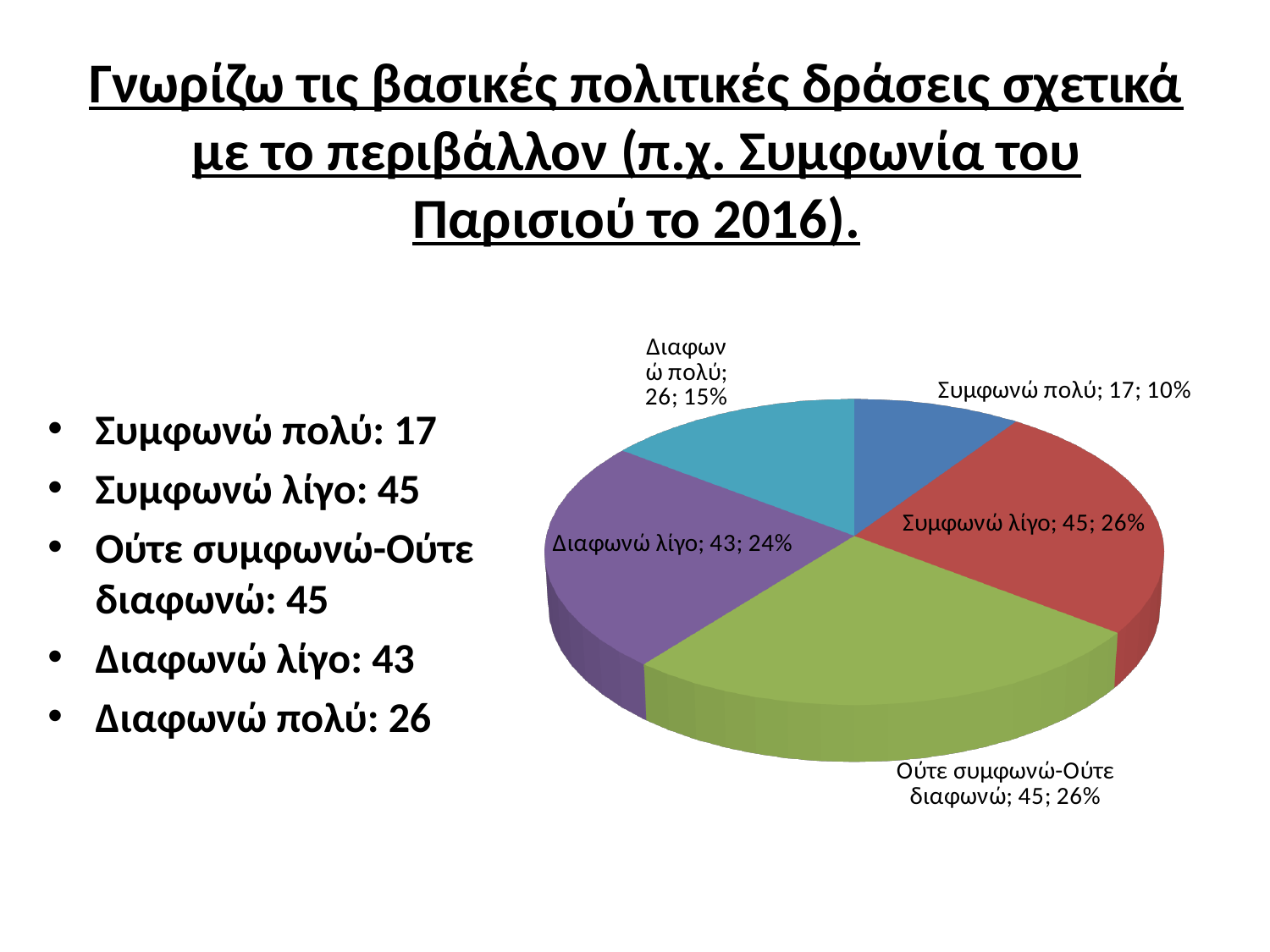
What colour is the Συμφωνώ πολύ slice in the pie chart? Blue What is the value for Συμφωνώ πολύ in the pie chart? 17 What is the difference between the values for Συμφωνώ λίγο and Συμφωνώ πολύ? 28 What is the value for Διαφωνώ πολύ in the pie chart? 26 Which is larger in the pie chart, Διαφωνώ λίγο or Διαφωνώ πολύ? Διαφωνώ λίγο How many slices does the pie chart have? 5 Which category has the smallest slice in the pie chart? Συμφωνώ πολύ What percentage share does Συμφωνώ πολύ have in the pie chart? 10% What is the value for Διαφωνώ λίγο in the pie chart? 43 What kind of chart is shown on the slide? Pie chart What is the difference between the values for Διαφωνώ λίγο and Διαφωνώ πολύ? 17 What percentage share does Διαφωνώ λίγο have in the pie chart? 24%